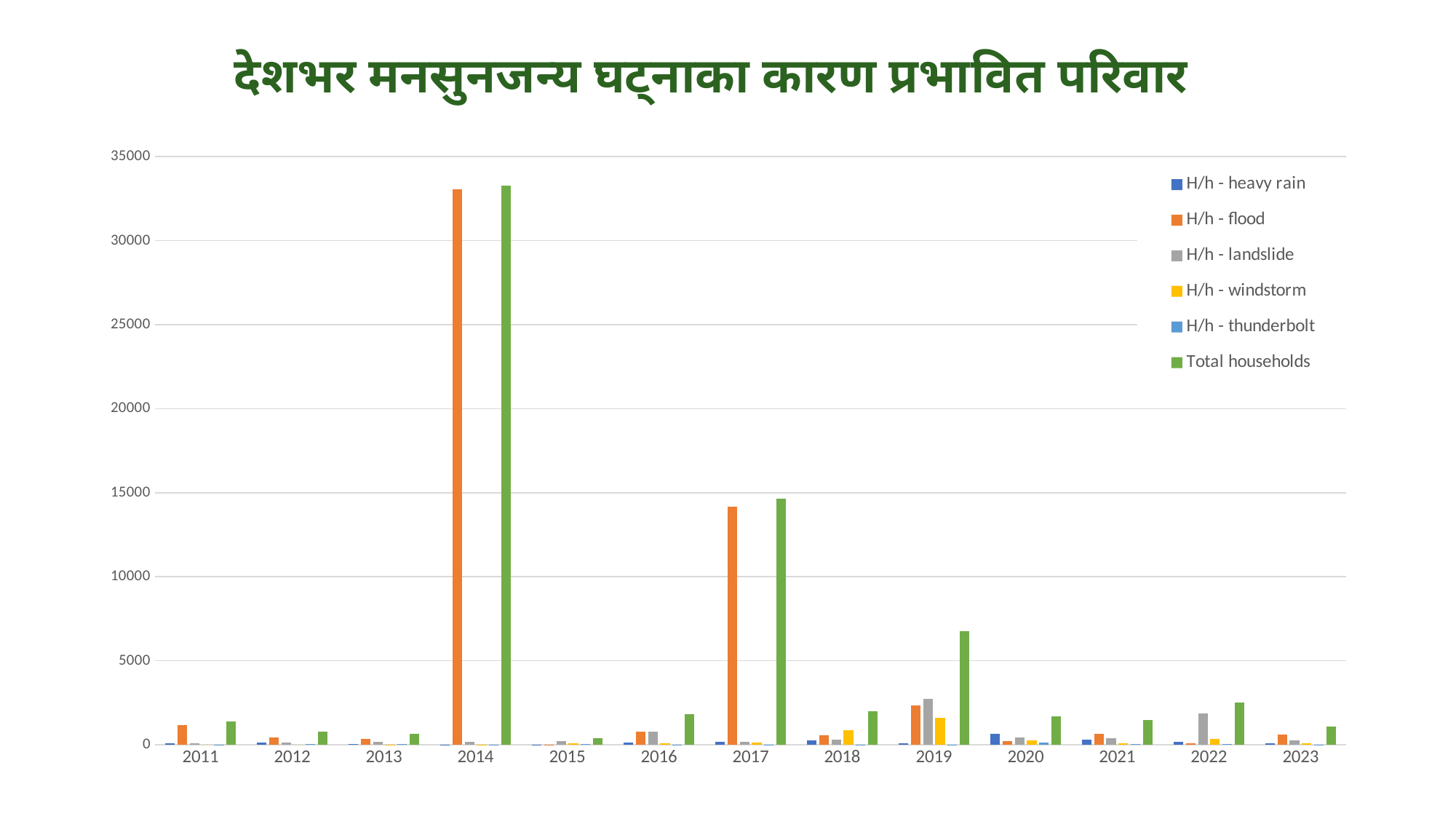
How many series does the legend list? 6 Is the value for Total households in 2022 greater or less than 5000? less How many years are shown on the x axis? 13 What kind of chart is shown on the slide? bar chart Which is larger, Total households in 2014 or Total households in 2017? 2014 Which is larger, H/h - landslide in 2019 or H/h - landslide in 2022? 2019 What colour represents the Total households series in the legend? green Is the value for Total households in 2019 greater or less than 5000? greater Which year has the highest value for Total households? 2014 Which year has the lowest value for Total households? 2015 Is the value for Total households in 2014 greater or less than 30000? greater